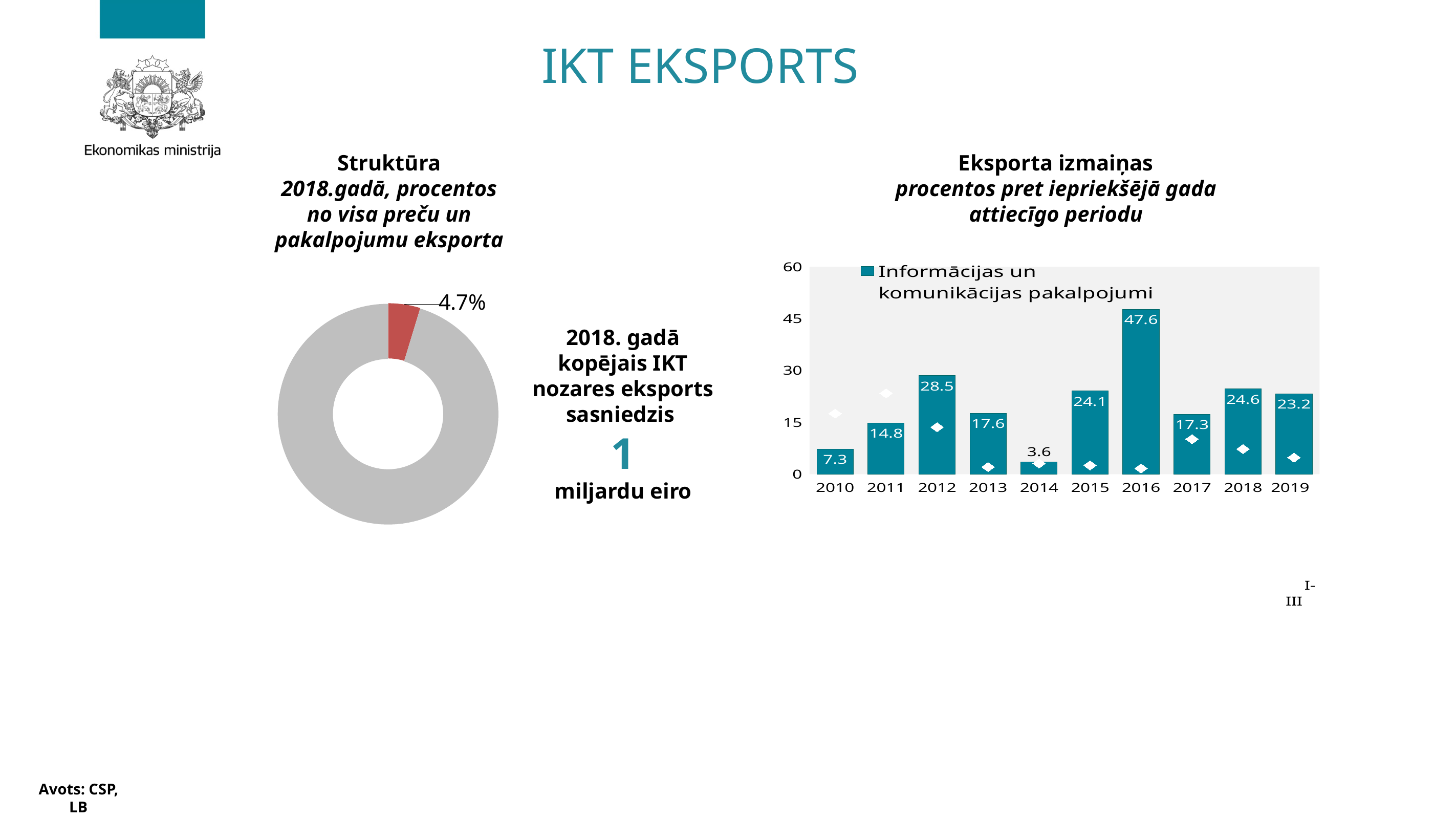
In the 'Eksporta izmaiņas' chart, what is the value for 2019? 23.2 What kind of chart is the 'Eksporta izmaiņas' chart? bar chart In the 'Eksporta izmaiņas' chart, what is the value for 2014? 3.6 In the 'Struktūra' chart, what share does the red slice represent? 4.7% In the 'Eksporta izmaiņas' chart, which year has the highest bar? 2016 What kind of chart is the 'Struktūra' chart on the left? donut chart In the 'Eksporta izmaiņas' chart, which is larger, the value for 2011 or the value for 2013? 2013 In the 'Eksporta izmaiņas' chart, how many years are shown on the x axis? 10 In the 'Eksporta izmaiņas' chart, how many series does the legend list? 1 In the 'Eksporta izmaiņas' chart, what is the value for 2016? 47.6 In the 'Eksporta izmaiņas' chart, what is the difference between the values for 2016 and 2012? 19.1 In the 'Eksporta izmaiņas' chart, which year has the lowest bar? 2014